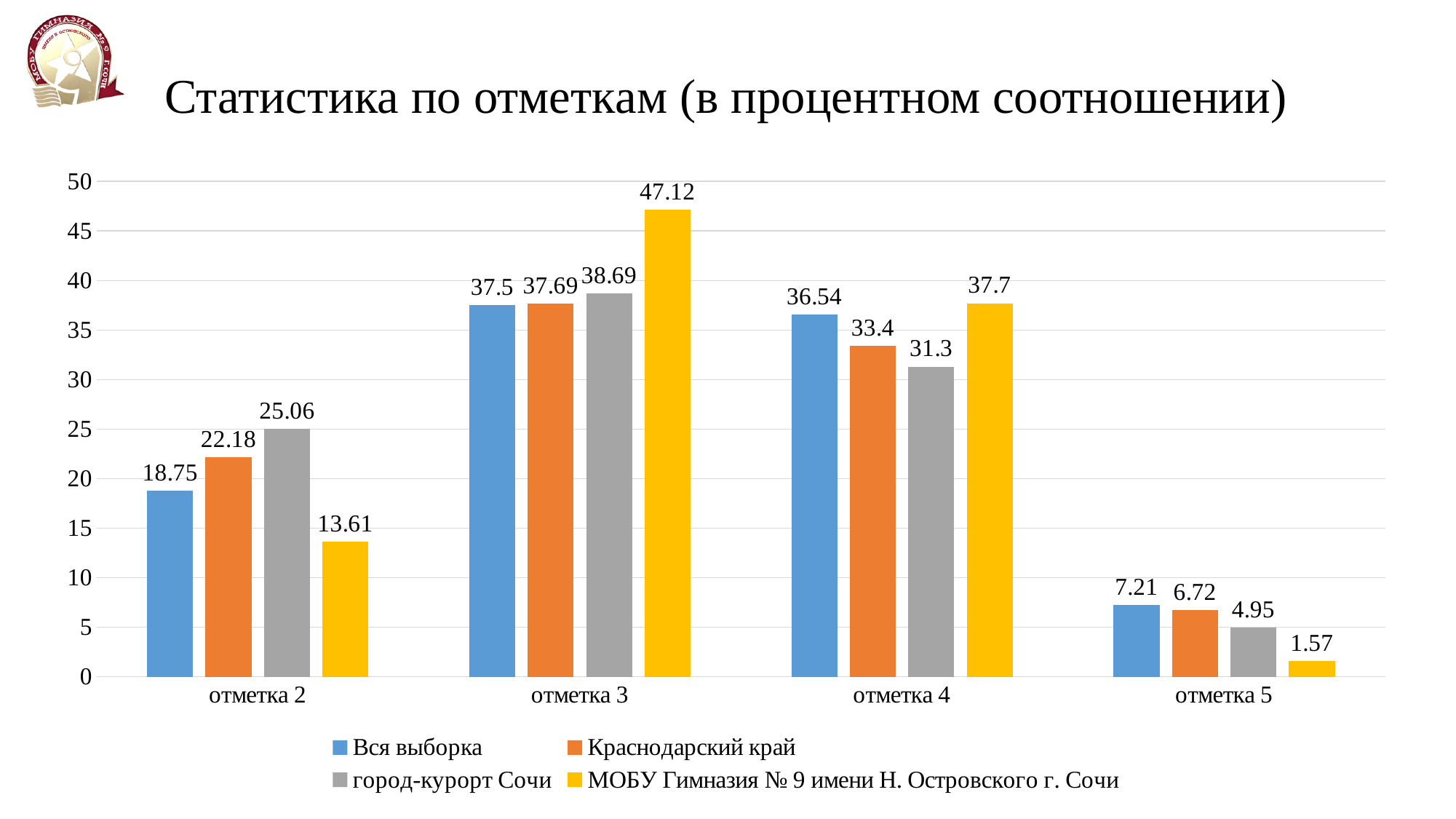
What is the value for Вся выборка at отметка 2? 18.75 What is the difference between the МОБУ Гимназия № 9 value and the город-курорт Сочи value at отметка 3? 8.43 Is the value for Краснодарский край at отметка 4 greater or less than 30? greater What is the difference between the город-курорт Сочи value and the МОБУ Гимназия № 9 value at отметка 2? 11.45 What kind of chart is shown on the slide? bar chart Which is larger at отметка 4: Вся выборка or Краснодарский край? Вся выборка How many series does the legend list? 4 Which series has the highest value at отметка 2? город-курорт Сочи What is the value for город-курорт Сочи at отметка 5? 4.95 Which series has the lowest value at отметка 5? МОБУ Гимназия № 9 имени Н. Островского г. Сочи How many categories are shown on the x axis? 4 What is the value for МОБУ Гимназия № 9 имени Н. Островского г. Сочи at отметка 3? 47.12